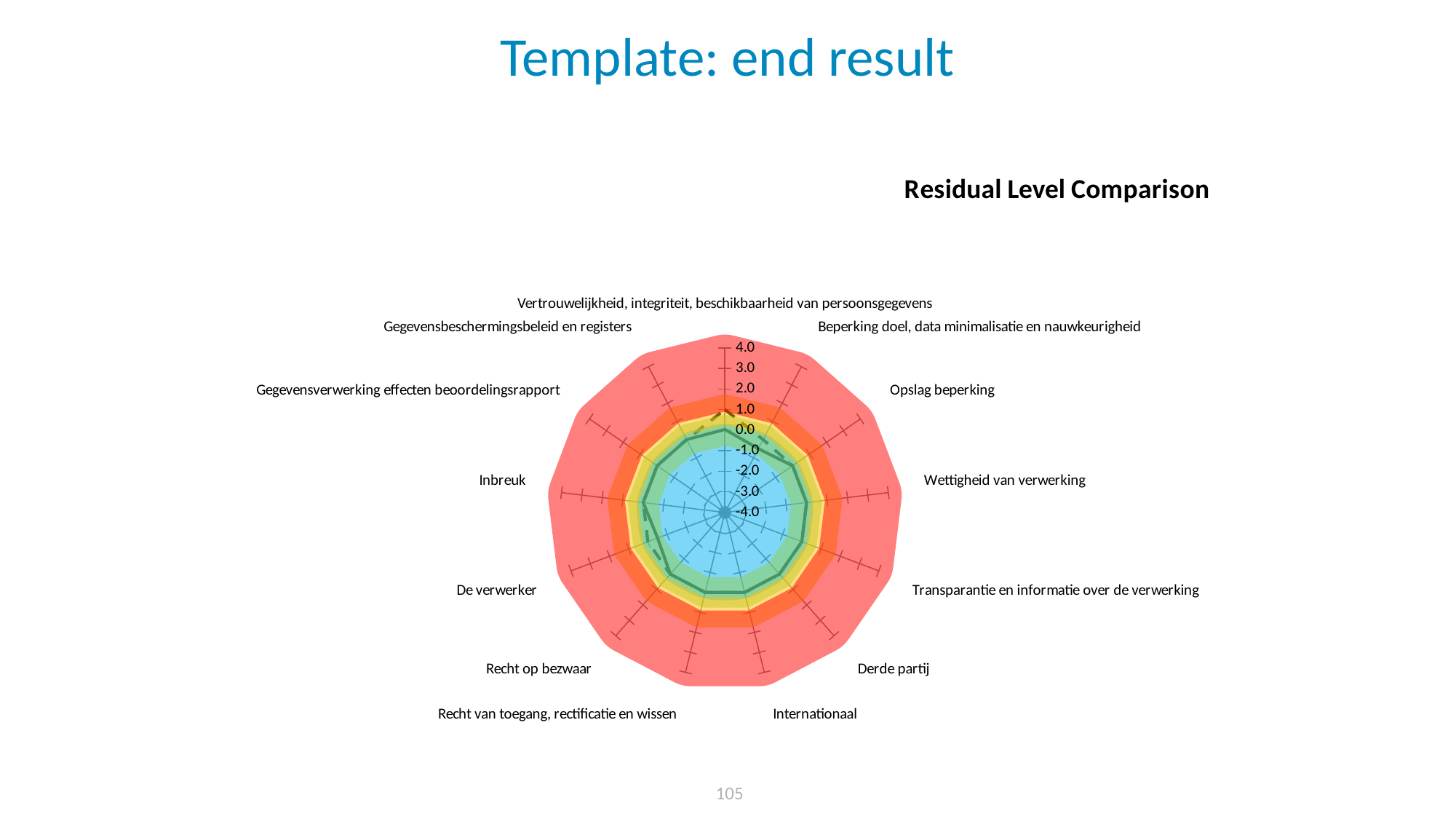
What is the highest value labelled on the chart's radial axis? 4.0 How many categories (axes) does the radar chart have? 13 Is the value of the solid green line for Wettigheid van verwerking greater or less than 2.0? less Is the value of the solid green line for Derde partij greater or less than 3.0? less What is the title of the chart? Residual Level Comparison Is the value of the solid green line for Wettigheid van verwerking greater or less than -2.0? greater What kind of chart is shown on the slide? Radar chart